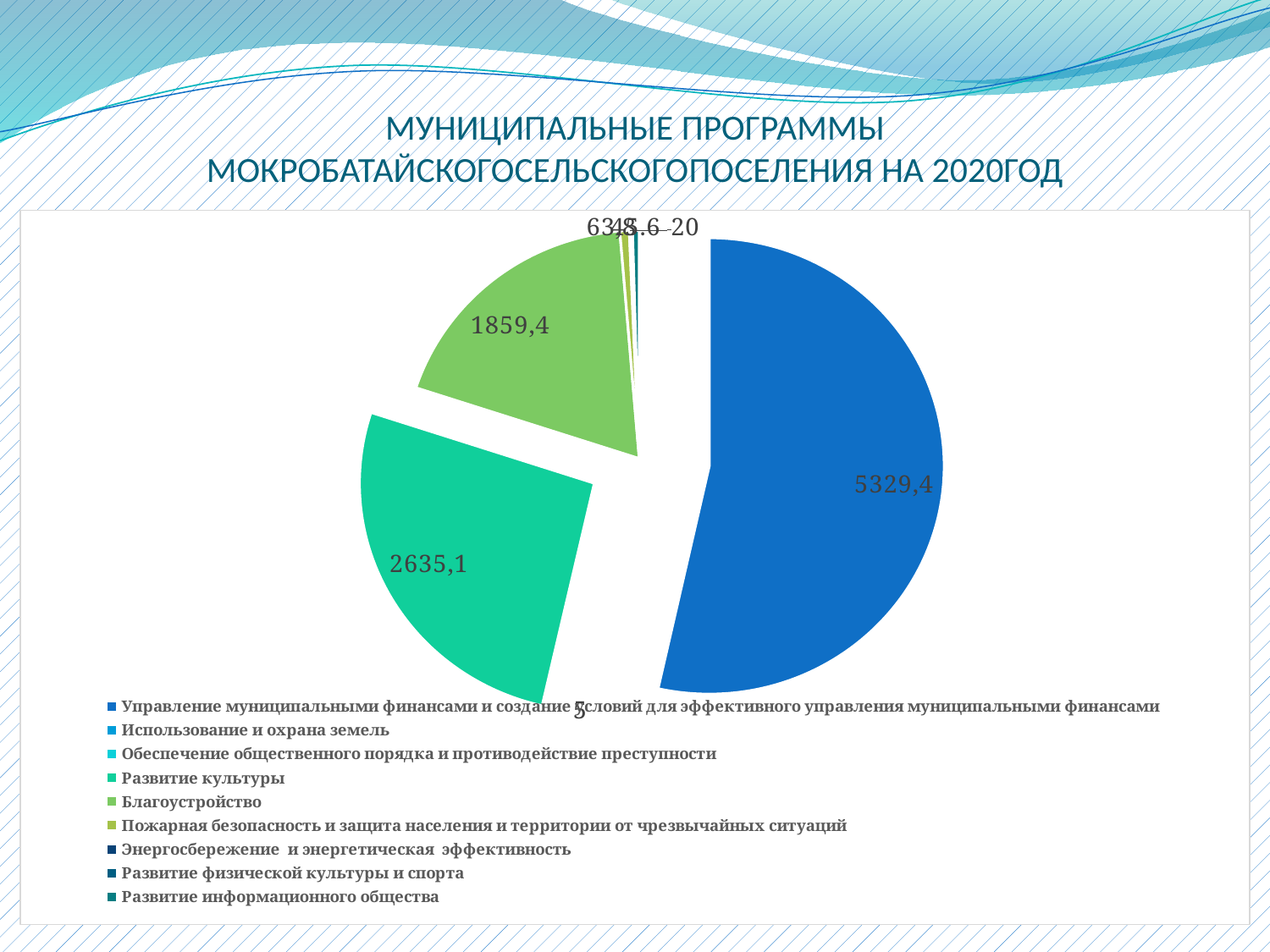
Which legend entry is shown in dark blue? Управление муниципальными финансами и создание условий для эффективного управления муниципальными финансами What is the value for Управление муниципальными финансами и создание условий для эффективного управления муниципальными финансами? 5329,4 What is the difference between the value for Управление муниципальными финансами и создание условий для эффективного управления муниципальными финансами and the value for Развитие культуры? 2694,3 What is the difference between the value for Развитие культуры and the value for Благоустройство? 775,7 What is the value for Благоустройство? 1859,4 How many categories does the legend list? 9 Which category has the largest slice of the pie? Управление муниципальными финансами и создание условий для эффективного управления муниципальными финансами What is the value for Развитие культуры? 2635,1 What type of chart is shown on the slide? pie chart What is the title of the chart? МУНИЦИПАЛЬНЫЕ ПРОГРАММЫ МОКРОБАТАЙСКОГОСЕЛЬСКОГОПОСЕЛЕНИЯ НА 2020ГОД Which is larger, the value for Развитие культуры or the value for Благоустройство? Развитие культуры